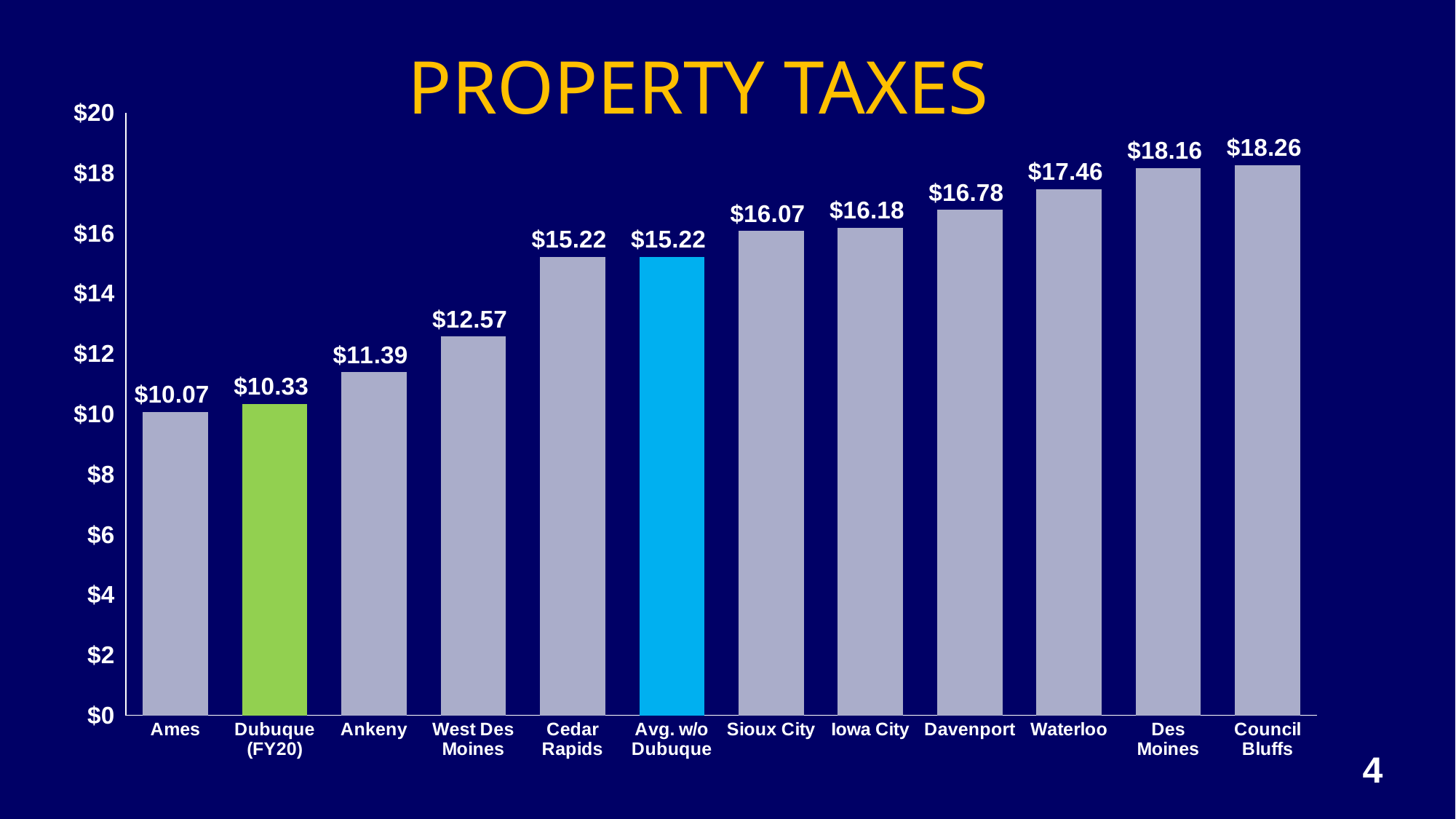
What kind of chart is shown on the slide? Bar chart Which category has the lowest value? Ames Which is larger, the value for Ankeny or the value for West Des Moines? West Des Moines Which category has the highest value? Council Bluffs What is the value for Waterloo? $17.46 What is the difference between the values for Avg. w/o Dubuque and Dubuque (FY20)? $4.89 What is the value for Dubuque (FY20)? $10.33 What is the value for Avg. w/o Dubuque? $15.22 What is the title of the chart? PROPERTY TAXES How many categories are shown on the x axis? 12 Is the value for Davenport greater or less than $16? greater What is the difference between the values for Council Bluffs and Ames? $8.19